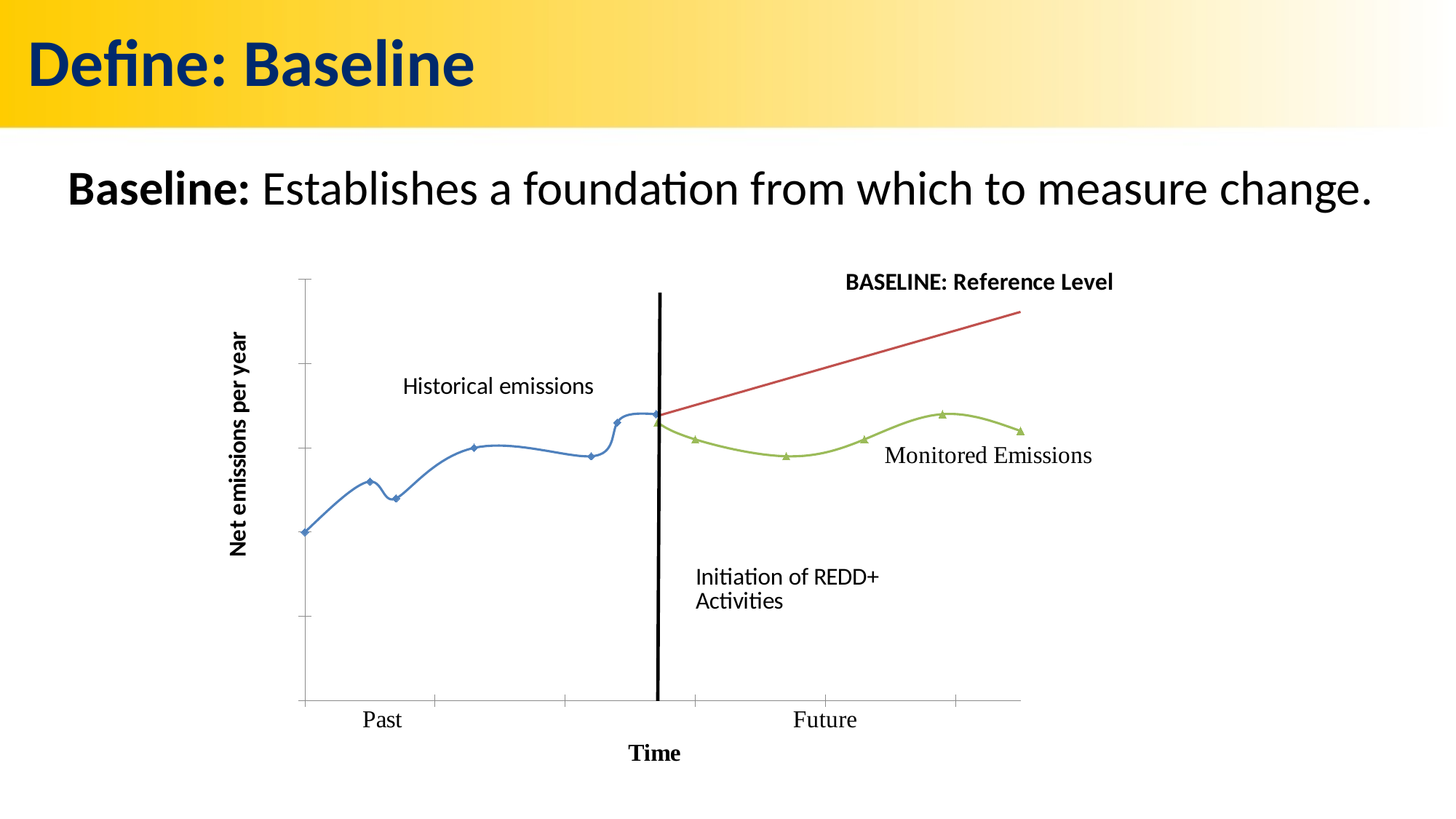
Overall, do the Historical emissions rise or fall from the start of the Past to the vertical line? rise At the far right of the chart, which is higher: the BASELINE: Reference Level or the Monitored Emissions? BASELINE: Reference Level After the initiation of REDD+ activities, are the Monitored Emissions above or below the BASELINE: Reference Level? below Does the BASELINE: Reference Level line rise or fall as time moves into the future? rise What does the vertical black line on the chart mark? Initiation of REDD+ Activities Are the Historical emissions higher at the vertical line or at the start of the Past period? at the vertical line What kind of chart is shown on the slide? line chart What is the label on the vertical axis of the chart? Net emissions per year